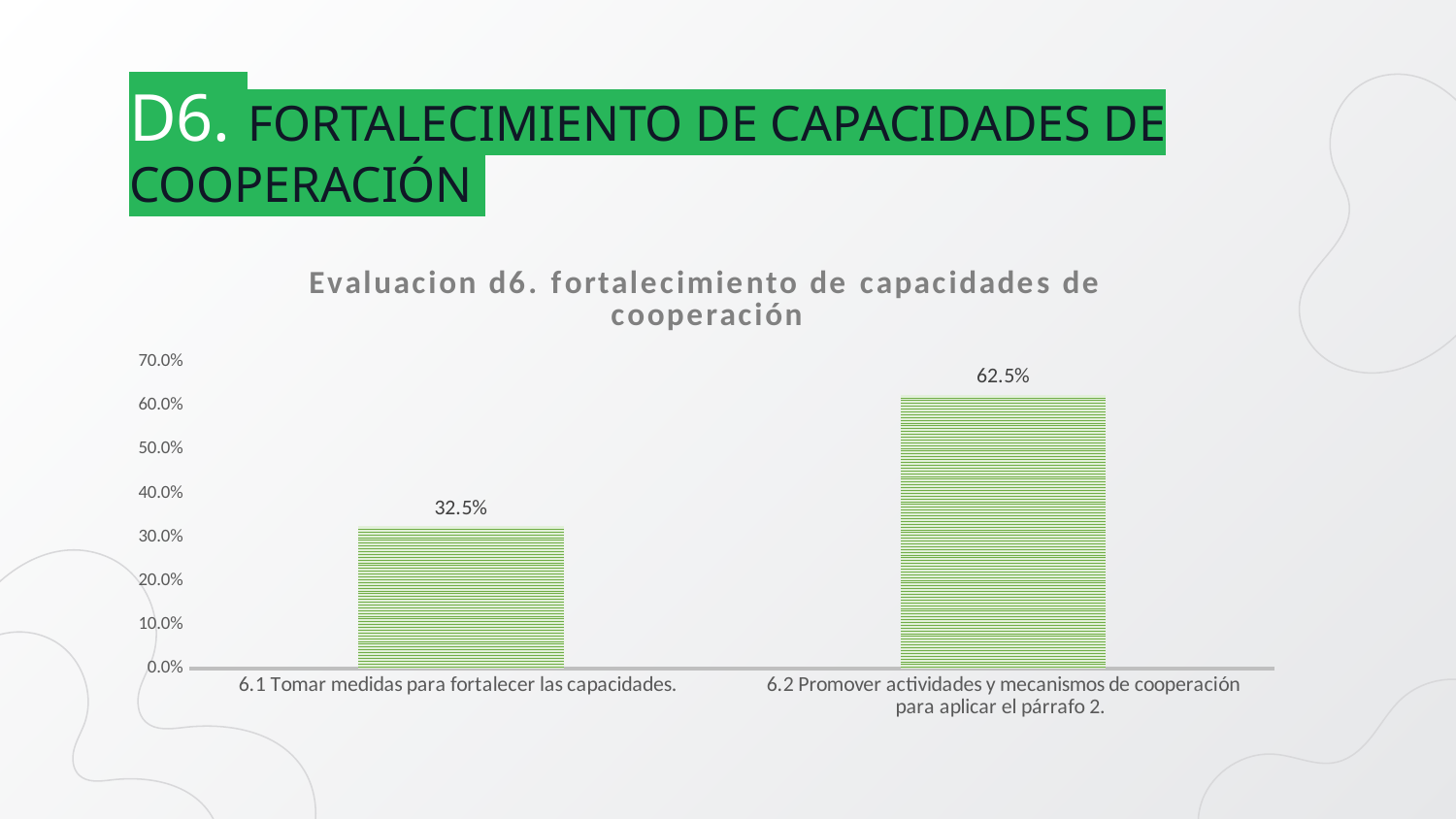
How many categories are shown in the chart? 2 Which category has the lowest value? 6.1 Tomar medidas para fortalecer las capacidades. What kind of chart is shown on the slide? bar chart What is the highest value shown on the y axis? 70.0% Is the value for 6.2 greater or less than 50.0%? greater What is the title of the chart? Evaluacion d6. fortalecimiento de capacidades de cooperación What is the value for "6.1 Tomar medidas para fortalecer las capacidades."? 32.5% Which is larger, the value for 6.1 or the value for 6.2? 6.2 What is the value for "6.2 Promover actividades y mecanismos de cooperación para aplicar el párrafo 2."? 62.5% Is the value for 6.1 greater or less than 40.0%? less Which category has the highest value? 6.2 Promover actividades y mecanismos de cooperación para aplicar el párrafo 2. What is the difference between the values for 6.2 and 6.1? 30.0%